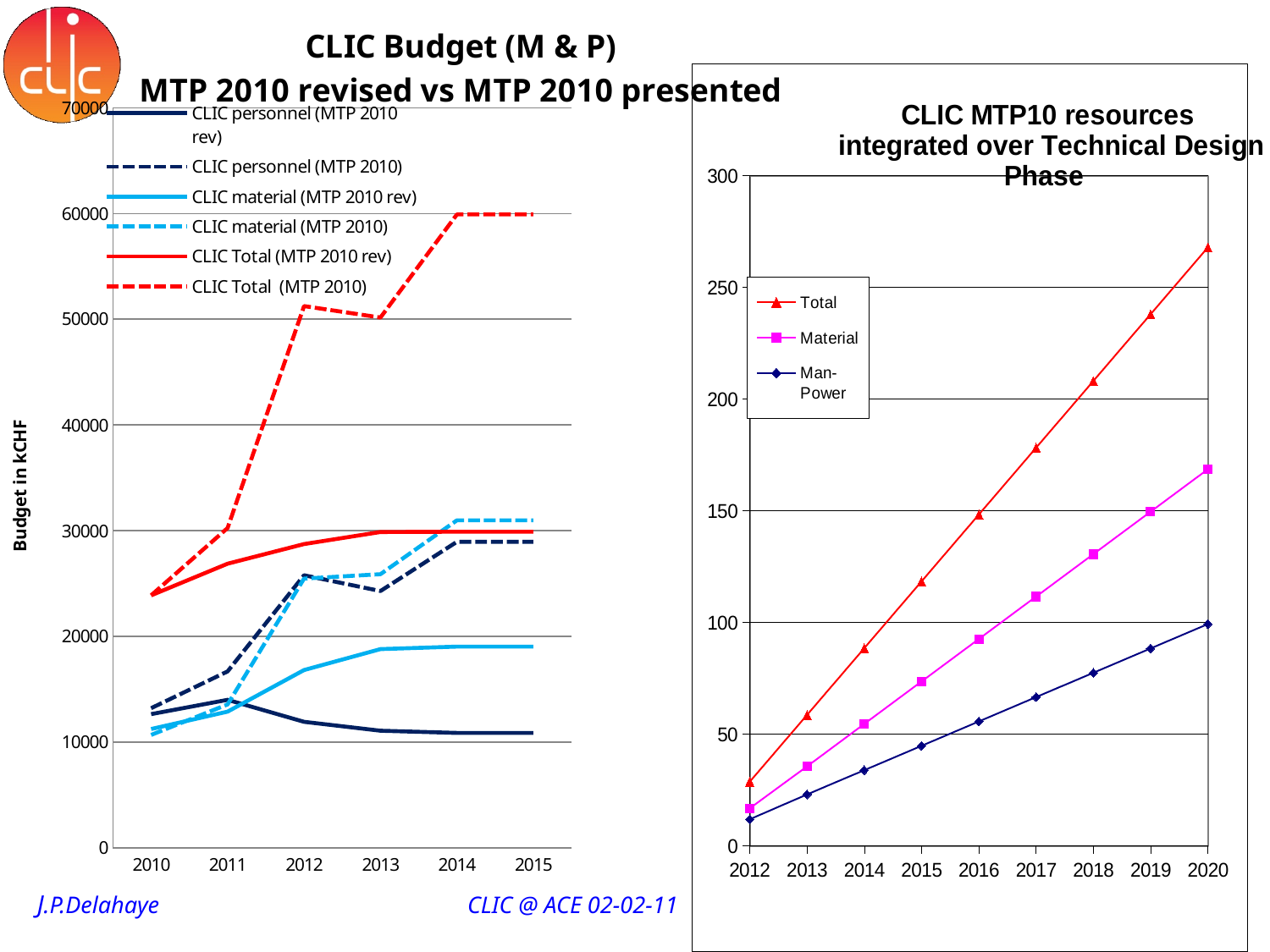
How many years are shown on the x axis of the left chart? 6 In the right chart, which series has the highest value in 2020? Total How many years are shown on the x axis of the right chart? 9 How many series does the legend of the right chart list? 3 In the left chart, does the CLIC personnel (MTP 2010 rev) series rise or fall from 2011 to 2015? Fall What type of chart is the right chart, 'CLIC MTP10 resources integrated over Technical Design Phase'? Line chart What type of chart is the left chart, 'CLIC Budget (M & P) MTP 2010 revised vs MTP 2010 presented'? Line chart In the right chart, is the Total value for 2020 greater or less than 250? greater In the left chart, is the CLIC Total (MTP 2010) value for 2015 greater or less than 50000? greater How many series does the legend of the left chart list? 6 In the right chart, is the Material value for 2016 greater or less than 100? less